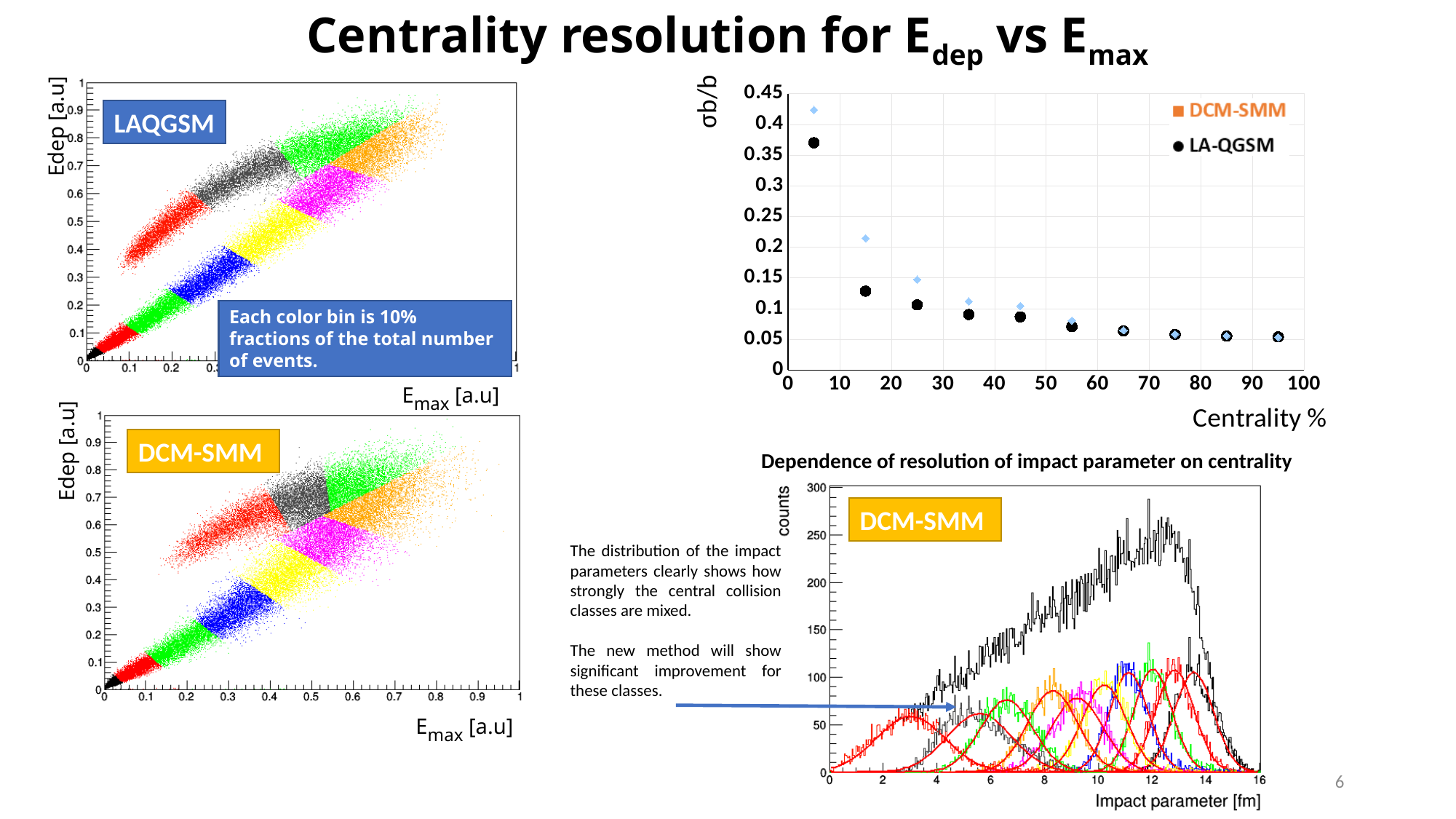
In the σb/b vs Centrality % chart, how many data points are plotted for the LA-QGSM series? 10 In the σb/b vs Centrality % chart, how many series does the legend list? 2 In the σb/b vs Centrality % chart, is the DCM-SMM value at centrality 15% greater or less than 0.15? greater In the σb/b vs Centrality % chart, which series has the larger value at centrality 5%, DCM-SMM or LA-QGSM? DCM-SMM In the σb/b vs Centrality % chart, which series has the larger value at centrality 15%, DCM-SMM or LA-QGSM? DCM-SMM In the σb/b vs Centrality % chart, do the σb/b values rise or fall as centrality increases? fall In the σb/b vs Centrality % chart, what are the two series named in the legend? DCM-SMM and LA-QGSM In the σb/b vs Centrality % chart, is the DCM-SMM value at centrality 5% greater or less than 0.4? greater In the σb/b vs Centrality % chart, is the LA-QGSM value at centrality 95% greater or less than 0.1? less In the DCM-SMM impact parameter histogram at the bottom right, what is the label of the x axis? Impact parameter [fm] In the σb/b vs Centrality % chart, what kind of chart is it? scatter chart